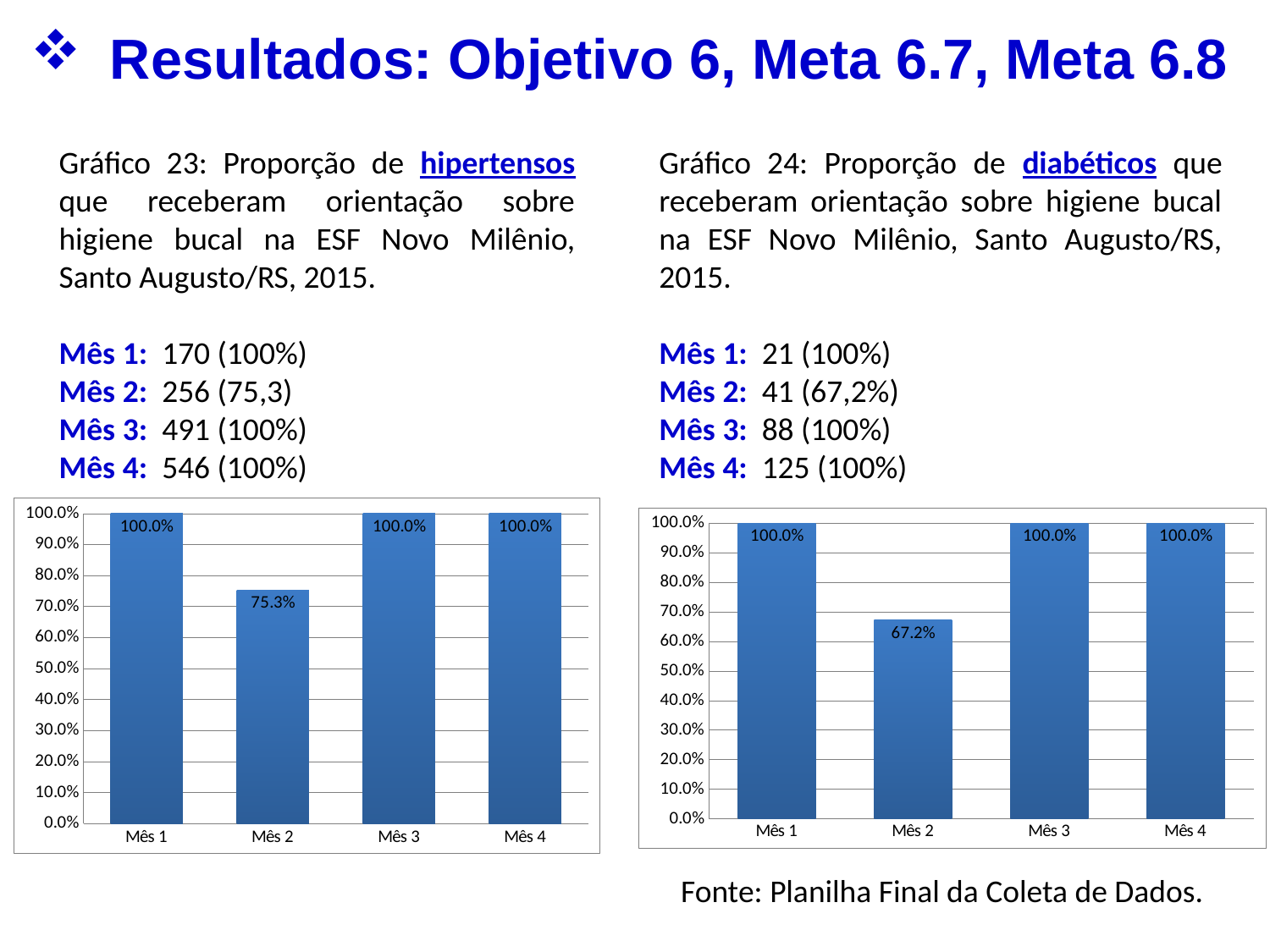
In Gráfico 24 (right chart), is the value for Mês 2 greater or less than 70.0%? less In Gráfico 23 (left chart), what is the value for Mês 2? 75.3% What kind of chart is Gráfico 24 (right chart)? bar chart How many months are shown on the x axis of Gráfico 23 (left chart)? 4 In Gráfico 23 (left chart), which month has the lowest value? Mês 2 Which is larger: the Mês 2 value in Gráfico 23 (left chart) or the Mês 2 value in Gráfico 24 (right chart)? Gráfico 23 (left chart) In Gráfico 23 (left chart), what is the value for Mês 4? 100.0% In Gráfico 24 (right chart), which month has the lowest value? Mês 2 In Gráfico 24 (right chart), what is the value for Mês 2? 67.2% According to the slide, what is the source of the data for the charts? Planilha Final da Coleta de Dados In Gráfico 23 (left chart), what is the difference between the values for Mês 1 and Mês 2? 24.7% In Gráfico 24 (right chart), what is the difference between the values for Mês 3 and Mês 2? 32.8%